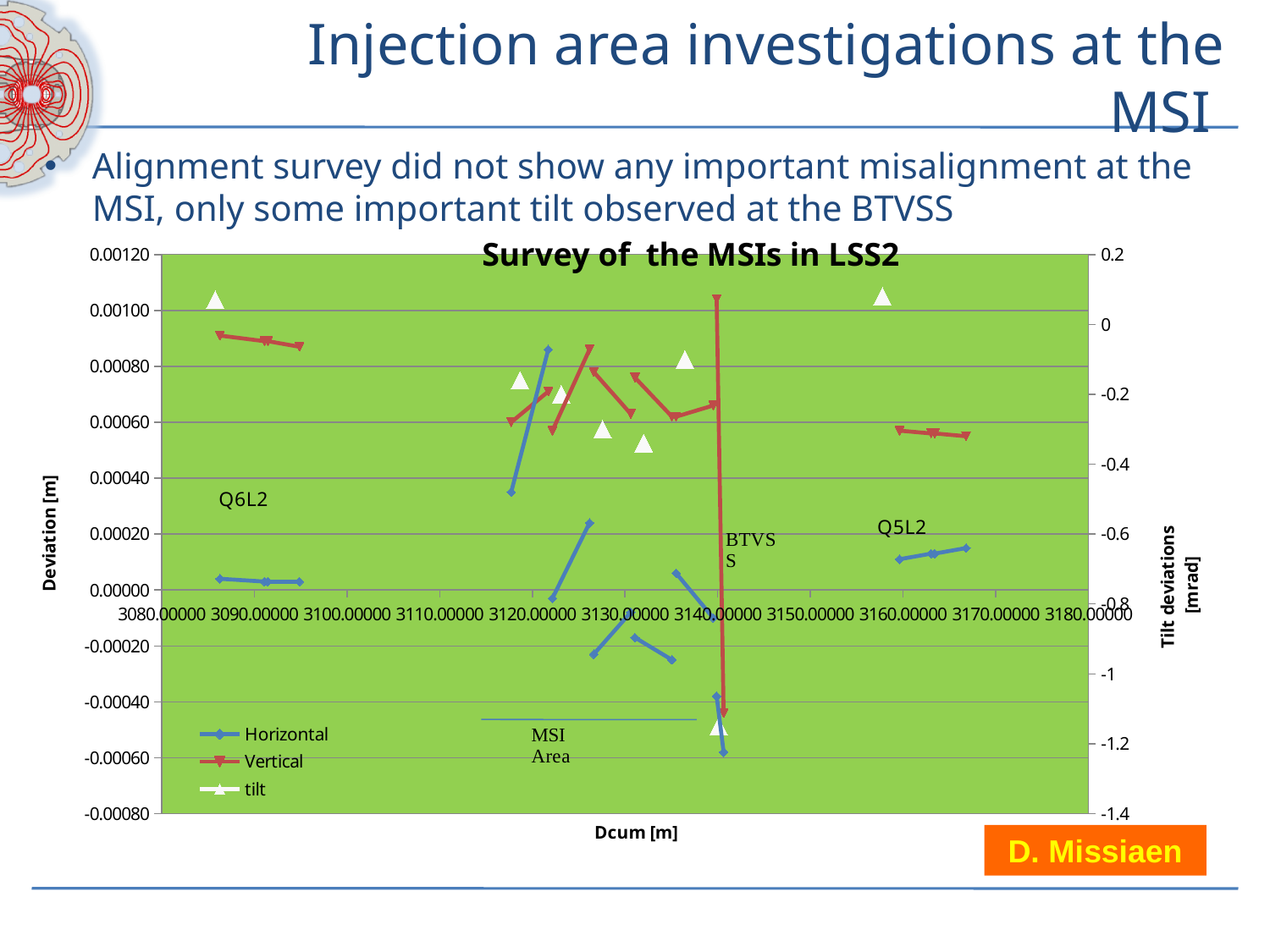
Is the lowest Horizontal deviation point at the BTVSS greater or less than -0.00040 m? less What is the title of the chart? Survey of the MSIs in LSS2 Is the Vertical deviation near Q6L2 (around 3090 m) greater or less than 0.00080 m? greater Is the Vertical deviation near Q5L2 (around 3165 m) greater or less than 0.00040 m? greater Which series is plotted with white triangle markers? tilt Near which labelled element does the tilt series reach its lowest value? BTVSS What is the label of the x axis of the chart? Dcum [m] How many series does the chart legend list? 3 What kind of chart is shown on the slide? Line chart